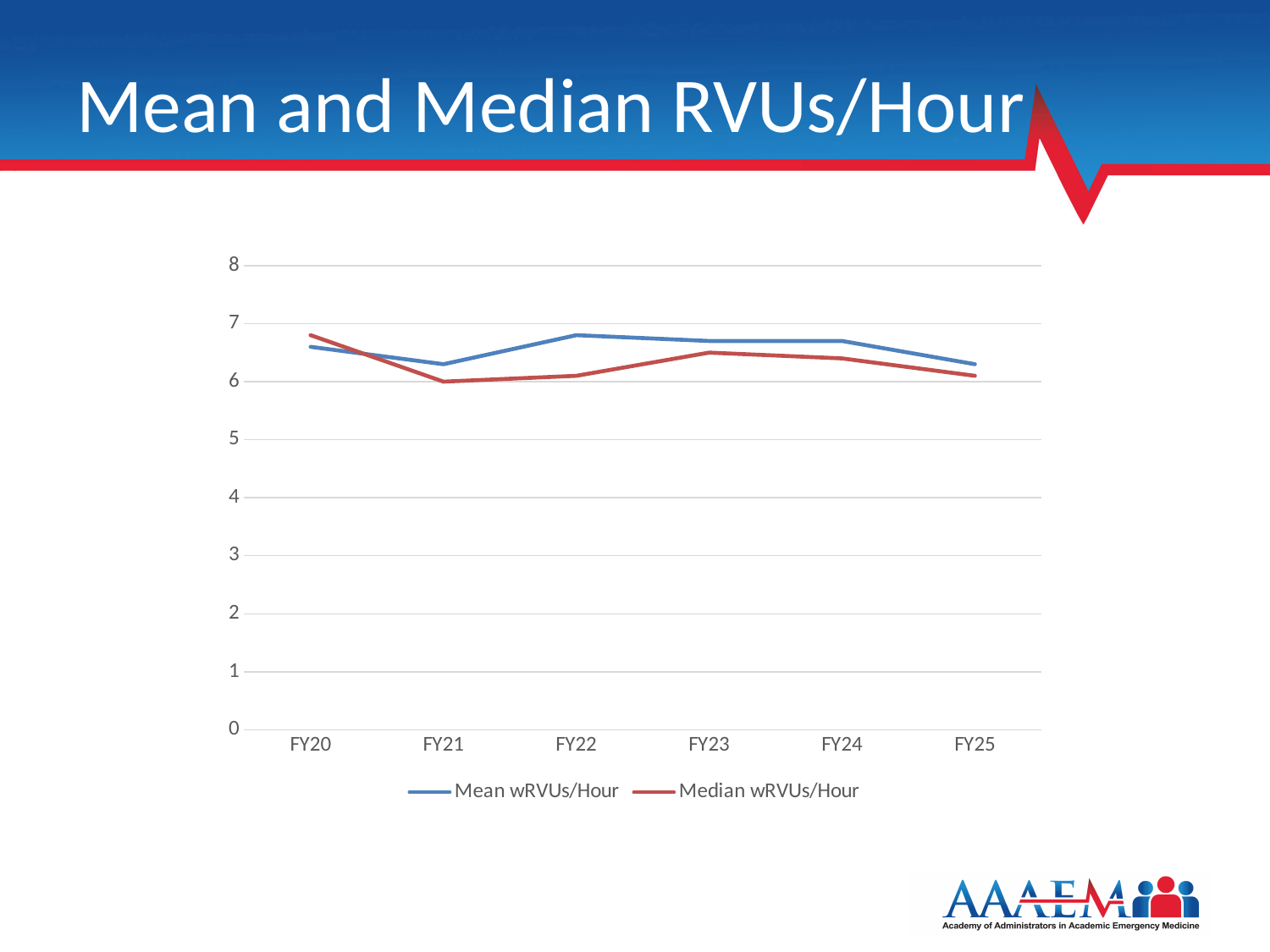
Which series is drawn in red? Median wRVUs/Hour What kind of chart is shown on the slide? line chart Does Mean wRVUs/Hour rise or fall from FY24 to FY25? fall What is the title of the slide's chart? Mean and Median RVUs/Hour How many fiscal years are plotted along the x axis? 6 Is the value for Median wRVUs/Hour in FY20 greater or less than 7? less How many series does the legend list? 2 Is the value for Mean wRVUs/Hour in FY22 greater or less than 6? greater In which fiscal year is Median wRVUs/Hour highest? FY20 In FY22, which is larger: Mean wRVUs/Hour or Median wRVUs/Hour? Mean wRVUs/Hour In FY20, which is larger: Mean wRVUs/Hour or Median wRVUs/Hour? Median wRVUs/Hour Is the value for Median wRVUs/Hour in FY23 greater or less than 6? greater